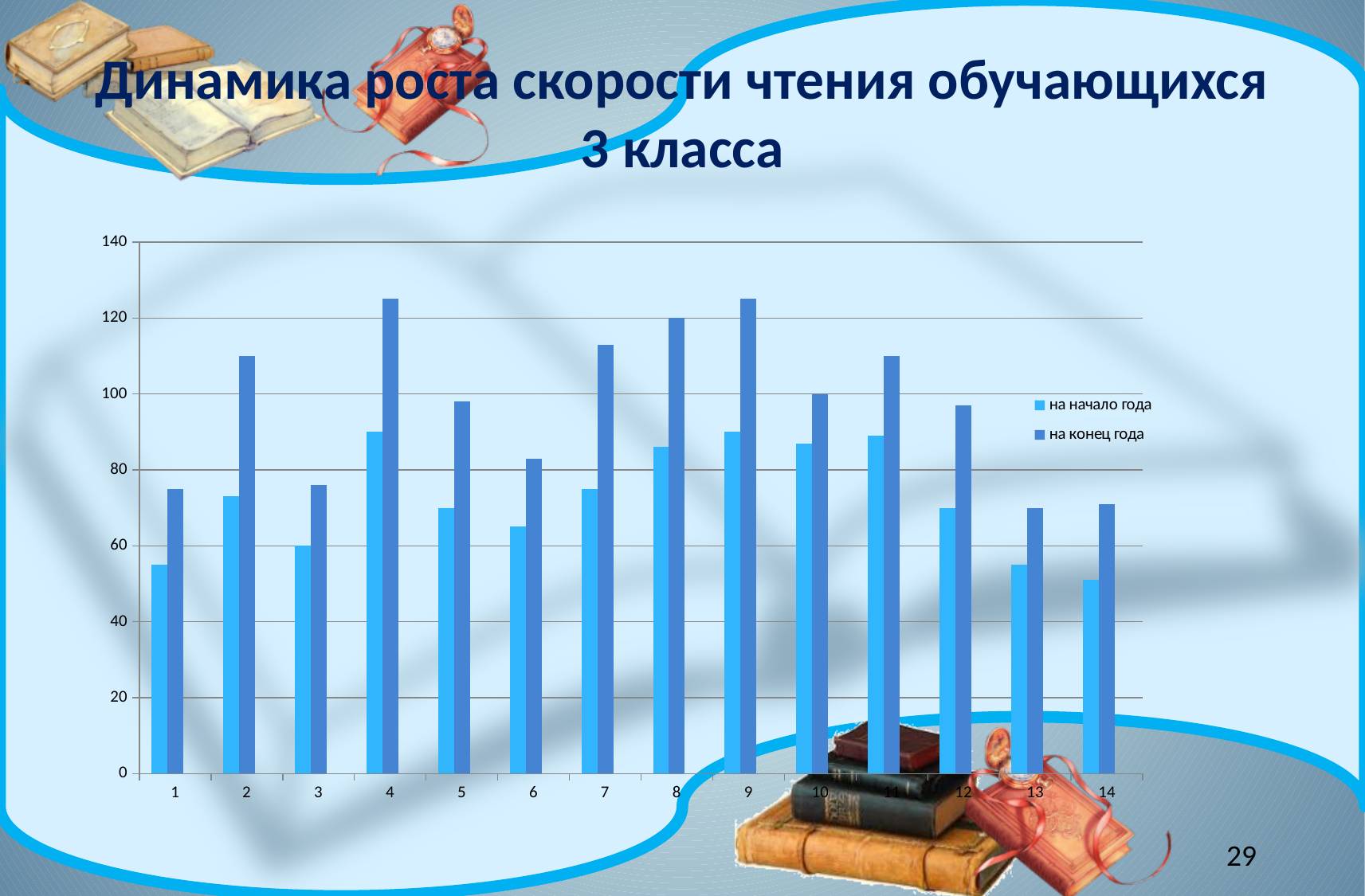
What kind of chart is shown on the slide? bar chart Is the value for category 7 in the series 'на конец года' greater or less than 100? greater Is the value for category 1 in the series 'на начало года' greater or less than 60? less What is the title of the slide containing the chart? Динамика роста скорости чтения обучающихся 3 класса In the series 'на конец года', which is larger: category 1 or category 2? category 2 Is the value for category 11 in the series 'на конец года' greater or less than 100? greater How many series does the chart's legend list? 2 How many categories are shown on the x axis of the chart? 14 For category 2, which series has the larger value: 'на начало года' or 'на конец года'? на конец года What are the two series named in the legend? на начало года, на конец года